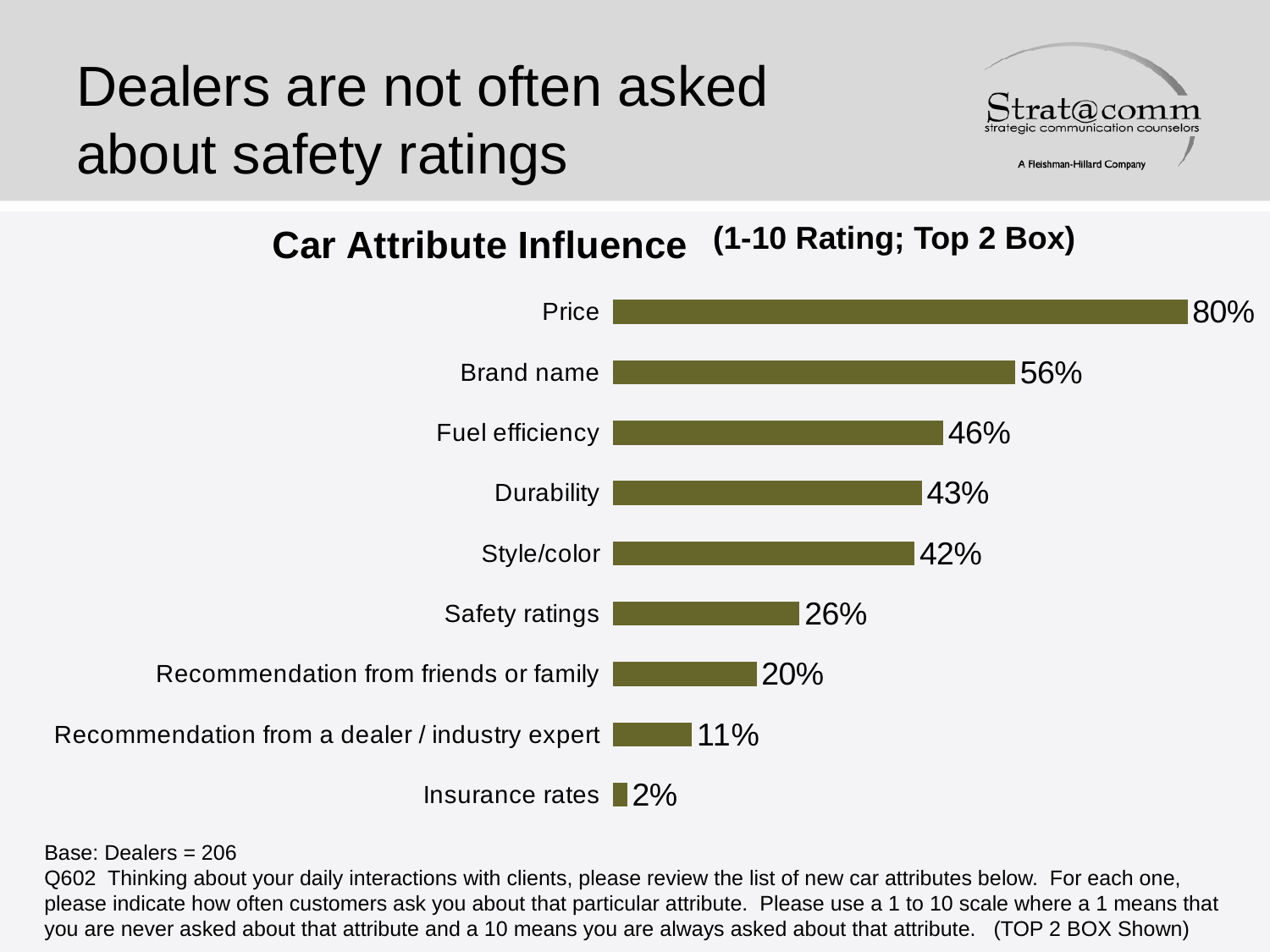
Which attribute has the highest value? Price What is the value for Safety ratings? 26% What is the value for Fuel efficiency? 46% What kind of chart is shown on the slide? Bar chart What is the difference between the values for Price and Brand name? 24% Which is larger, the value for Safety ratings or the value for Fuel efficiency? Fuel efficiency Which is larger, the value for Durability or the value for Style/color? Durability Which attribute has the lowest value? Insurance rates What is the title of the chart? Car Attribute Influence What is the difference between the values for Safety ratings and Recommendation from friends or family? 6% How many attributes are shown in the chart? 9 What is the value for Recommendation from a dealer / industry expert? 11%